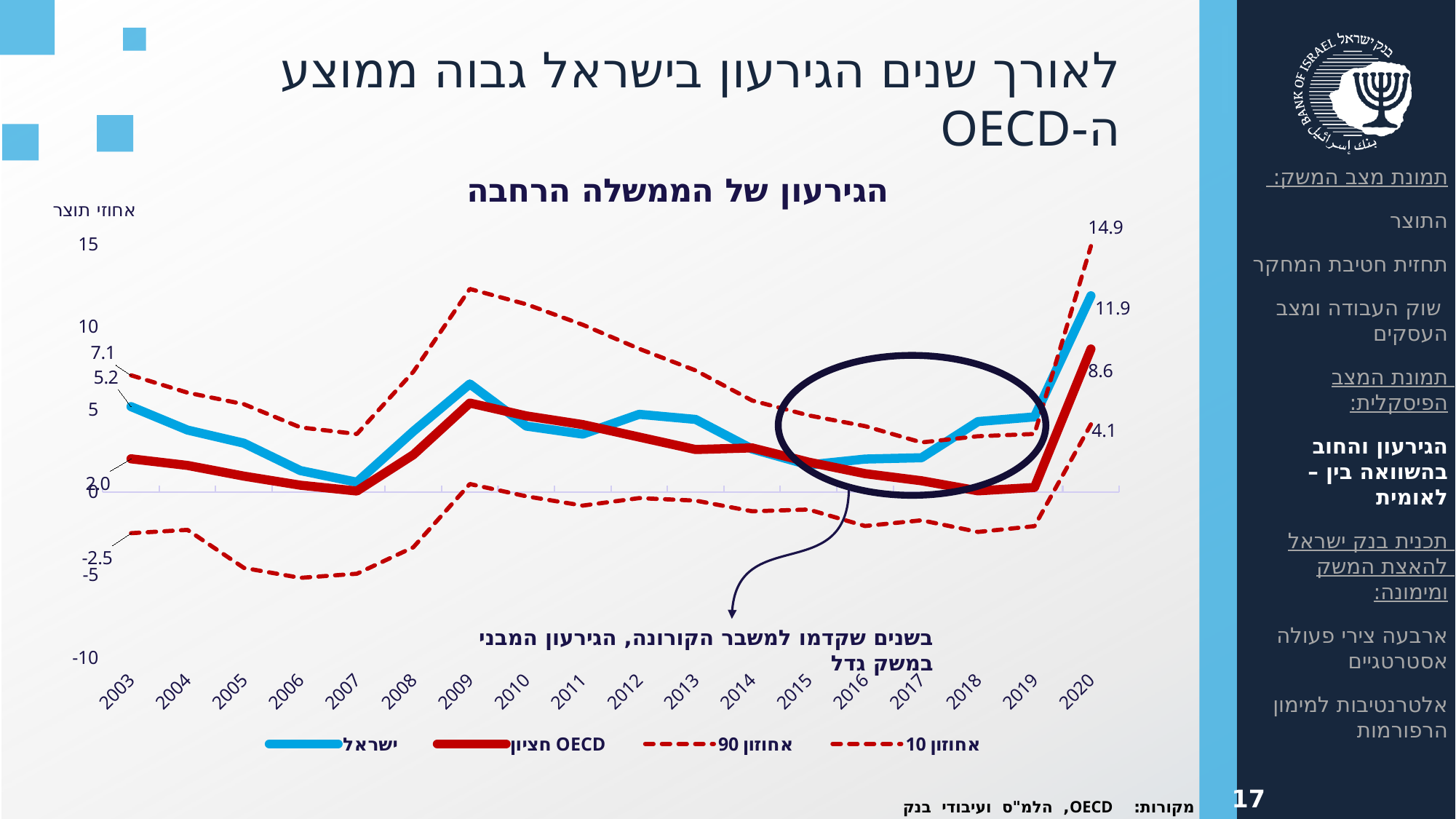
What is the value for אחוזון 90 (90th percentile) in 2020? 14.9 What type of chart is shown on the slide? line chart What is the difference between the ישראל (Israel) value and the חציון OECD value in 2020? 3.3 Which series has the highest value in 2020? אחוזון 90 What is the value for אחוזון 10 (10th percentile) in 2003? -2.5 What is the title of the chart? הגירעון של הממשלה הרחבה What is the value for ישראל (Israel) in 2003? 5.2 How many years are shown on the x axis? 18 How many series does the legend list? 4 What is the value for חציון OECD (OECD median) in 2020? 8.6 Is the value for ישראל (Israel) in 2009 greater or less than 10? less What is the value for ישראל (Israel) in 2020? 11.9